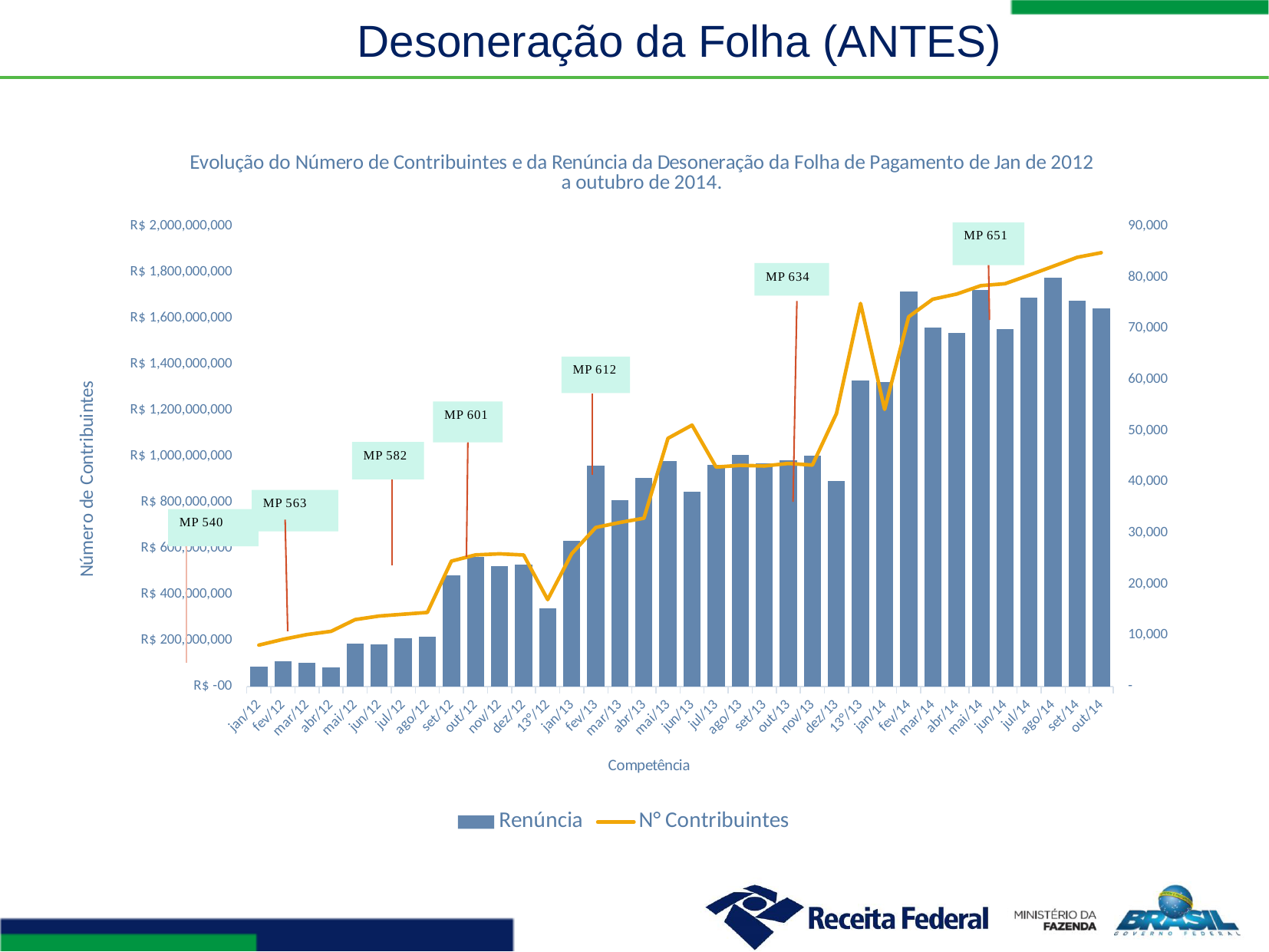
What is the title of the x axis? Competência What are the two series named in the legend? Renúncia and Nº Contribuintes How many categories (competências) are plotted along the x axis? 36 Is the Renúncia value for fev/13 greater or less than R$ 800,000,000? greater Is the Renúncia value for jan/12 greater or less than R$ 200,000,000? less Does the Nº Contribuintes line generally rise or fall from jan/12 to out/14? rise Is the Renúncia value for 13°/12 greater or less than R$ 400,000,000? less Which has the larger Renúncia value, jan/14 or fev/14? fev/14 What kind of chart is shown on the slide? A combination bar and line chart How many series does the legend list? 2